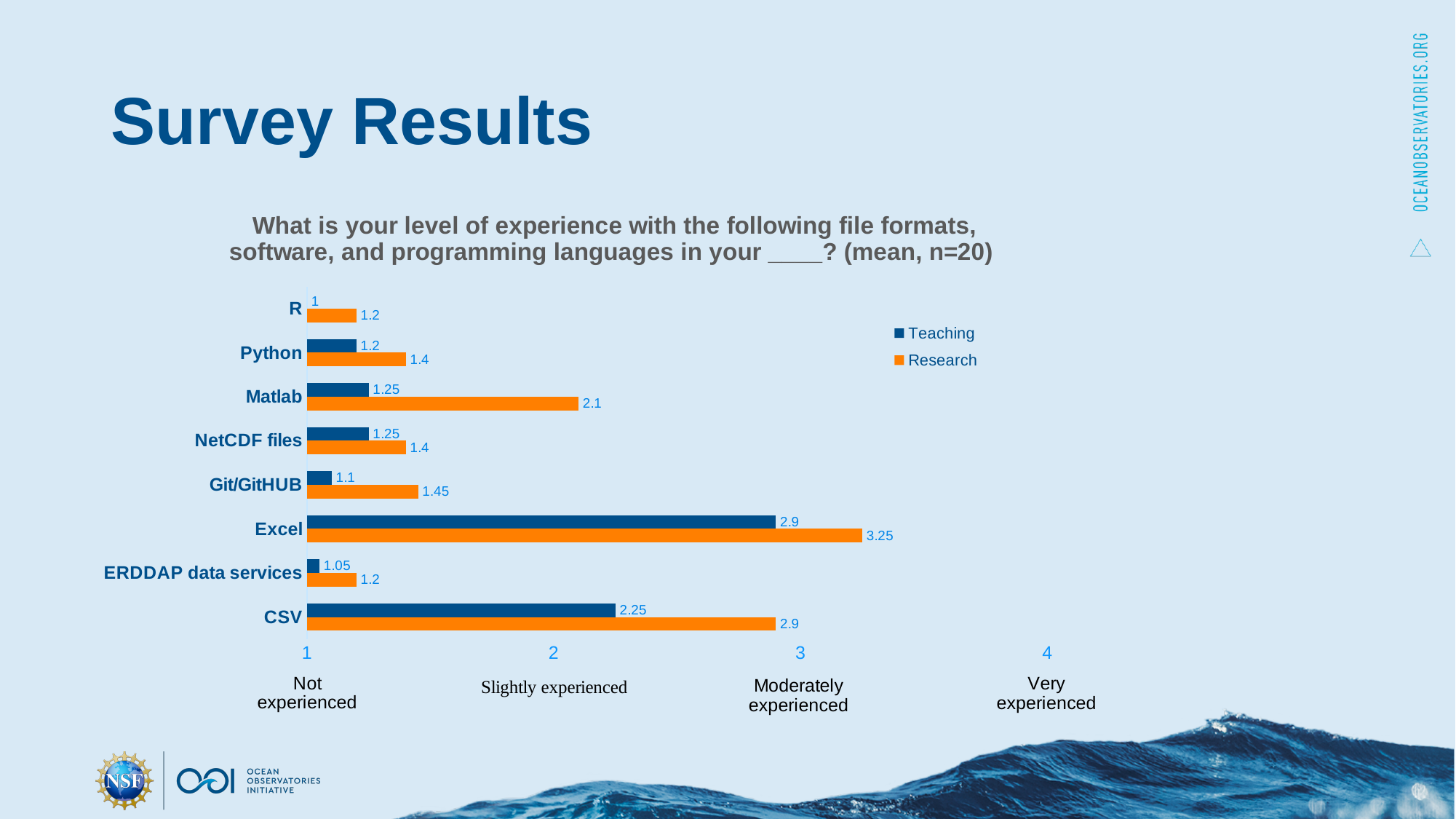
What kind of chart is shown on the slide? Bar chart What is the Research value for Excel? 3.25 Which category has the highest Research value? Excel What is the Teaching value for ERDDAP data services? 1.05 How many series does the legend list? 2 What is the difference between the Research and Teaching values for Matlab? 0.85 What is the Research value for Matlab? 2.1 How many categories are shown on the chart? 8 What is the Teaching value for CSV? 2.25 Which category has the lowest Teaching value? R Is the Research value for Excel greater or less than 3? greater Which is larger, the Teaching value for Excel or the Research value for CSV? They are equal (2.9)